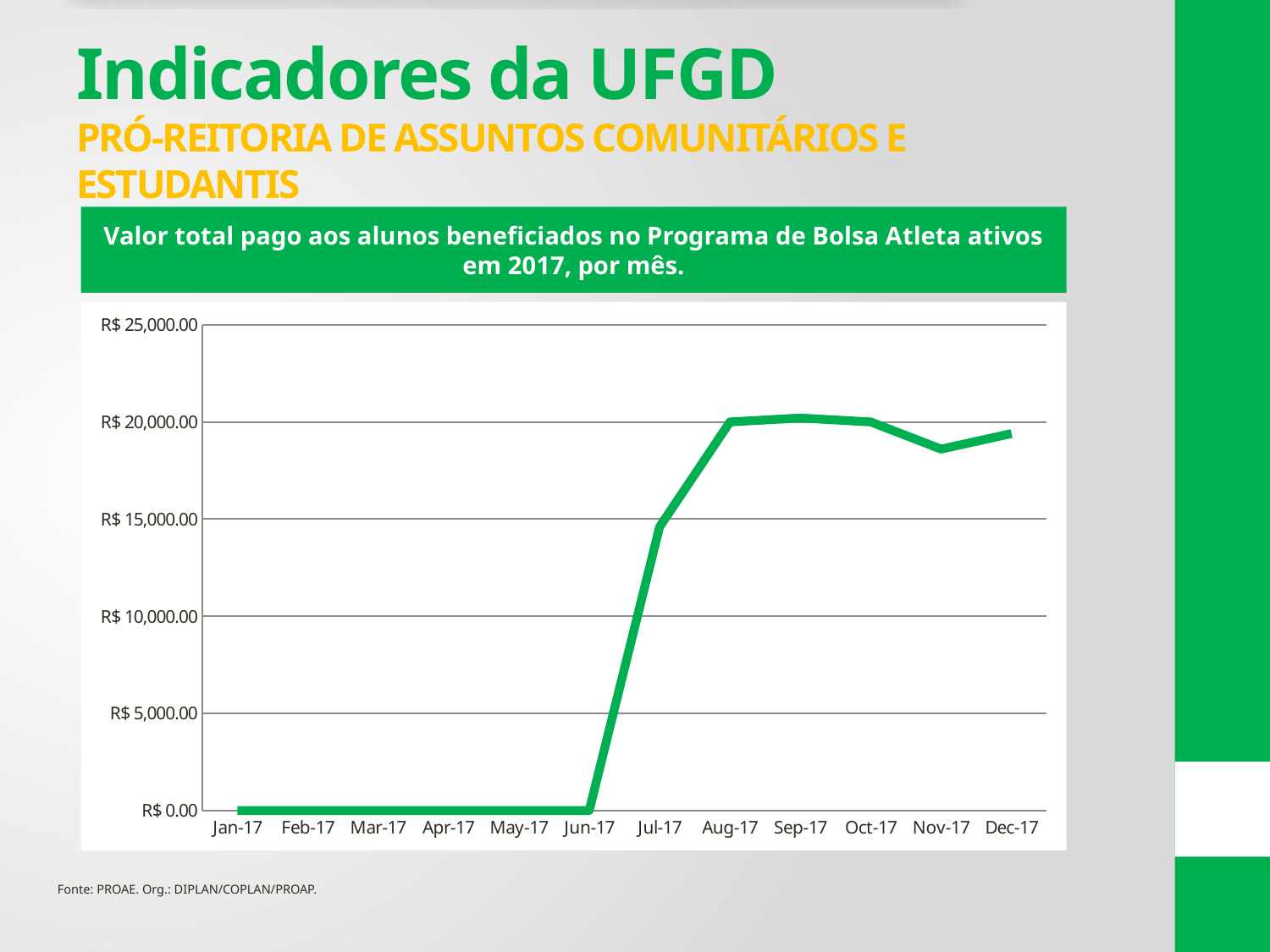
Which is larger, the value for Oct-17 or the value for Nov-17? Oct-17 What kind of chart is shown on the slide? line chart What colour is the plotted line? green What is the value for Jun-17? R$ 0.00 Is the value for Dec-17 greater or less than R$ 20,000.00? less Which is larger, the value for Jul-17 or the value for Aug-17? Aug-17 Do the values rise or fall overall from Jan-17 to Dec-17? rise What is the value for Jan-17? R$ 0.00 How many months are plotted on the x axis? 12 Is the value for Jul-17 greater or less than R$ 10,000.00? greater Is the value for Nov-17 greater or less than R$ 20,000.00? less